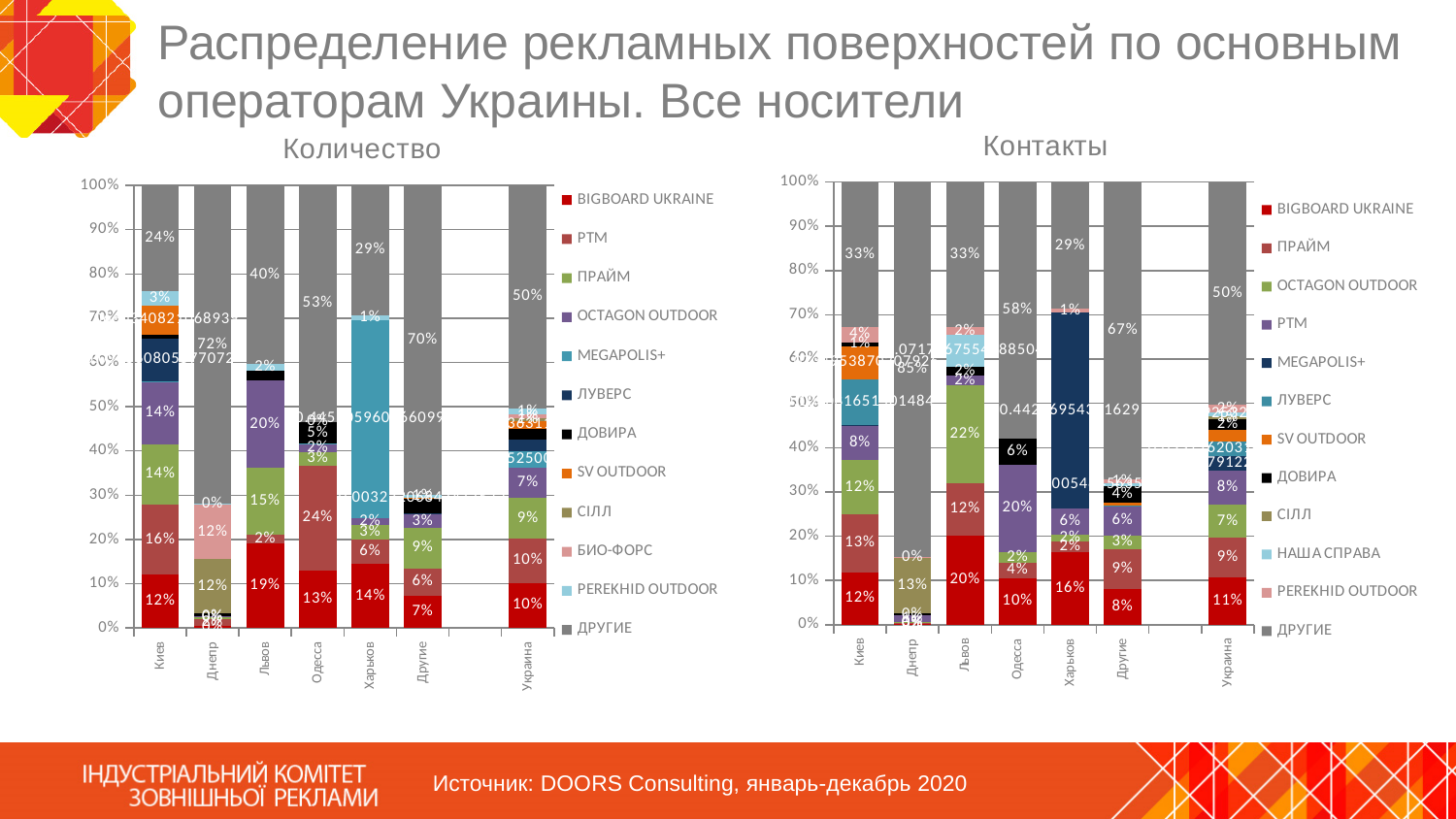
In the "Контакты" chart, what is the share of OCTAGON OUTDOOR for Львов? 22% What is the title of the chart on the right? Контакты What kind of chart is the "Количество" chart on the left? Stacked bar chart In the "Контакты" chart, what is the share of ДРУГИЕ for Одесса? 58% In the "Количество" chart, which region has the largest ДРУГИЕ share? Днепр In the "Контакты" chart, what is the share of BIGBOARD UKRAINE for Украина? 11% In the "Количество" chart, which is larger for Одесса: the РТМ share or the BIGBOARD UKRAINE share? РТМ In the "Контакты" chart, what is the difference between the ДРУГИЕ share for Другие and for Украина? 17% In the "Количество" chart, what is the share of ДРУГИЕ for Киев? 24% In the "Количество" chart, what is the share of BIGBOARD UKRAINE for Львов? 19% How many categories (regions) are shown on the x axis of the "Контакты" chart? 7 How many series does the legend of the "Количество" chart list? 12